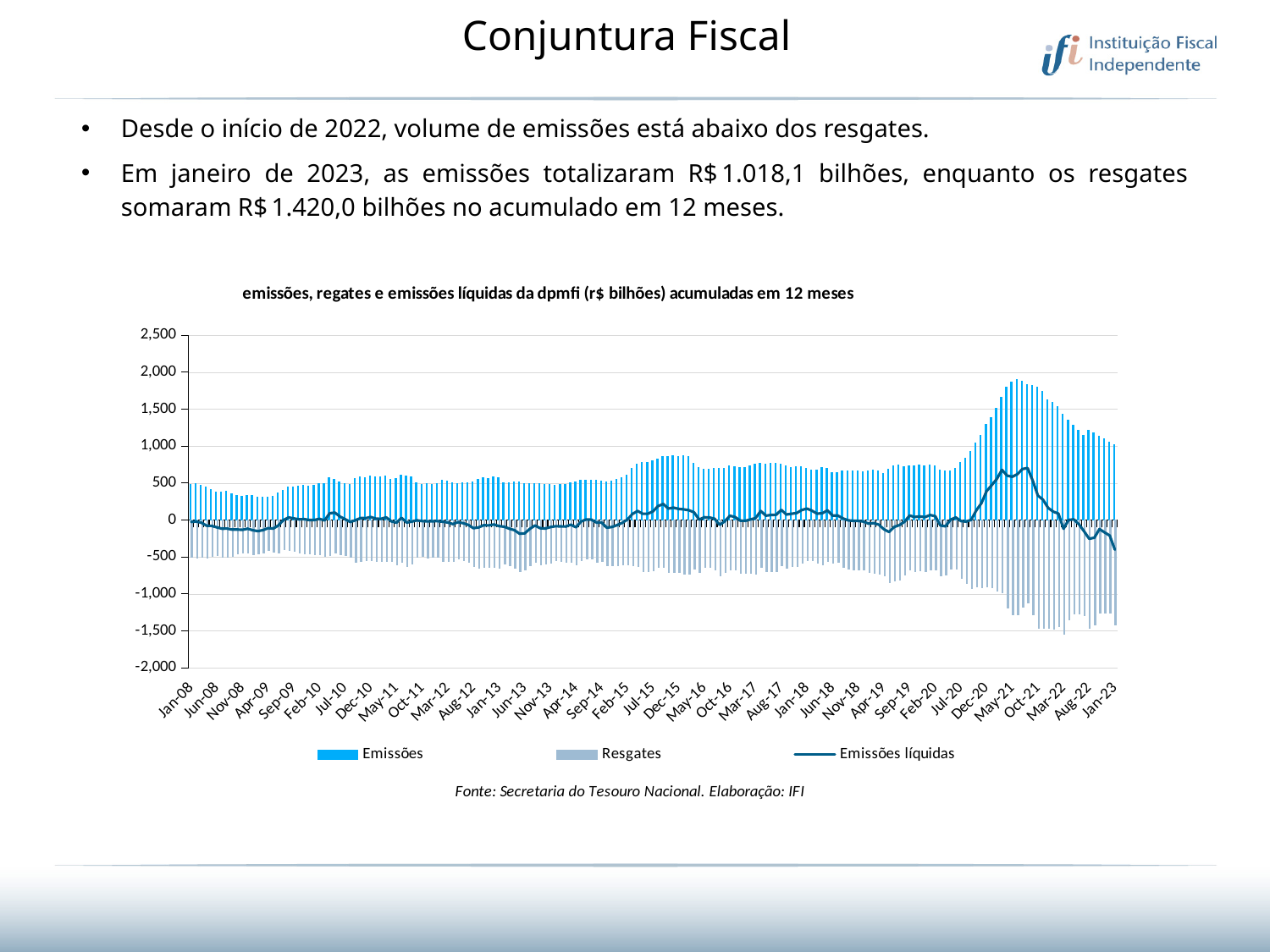
What is the title of the chart? emissões, regates e emissões líquidas da dpmfi (r$ bilhões) acumuladas em 12 meses Is the value for Emissões in Jan-23 greater or less than 500? greater Is the value for Emissões líquidas in May-21 greater or less than 500? greater Is the value for Emissões líquidas in Jan-23 greater or less than 0? less What are the three series listed in the chart legend? Emissões, Resgates, Emissões líquidas How many series does the chart legend list? 3 In which year do the Emissões bars reach their highest level? 2021 Does the Emissões líquidas line rise or fall between Aug-22 and Jan-23? Fall What kind of chart is shown on the slide? Bar chart with a line In Jan-23, which is larger in magnitude, Emissões or Resgates? Resgates